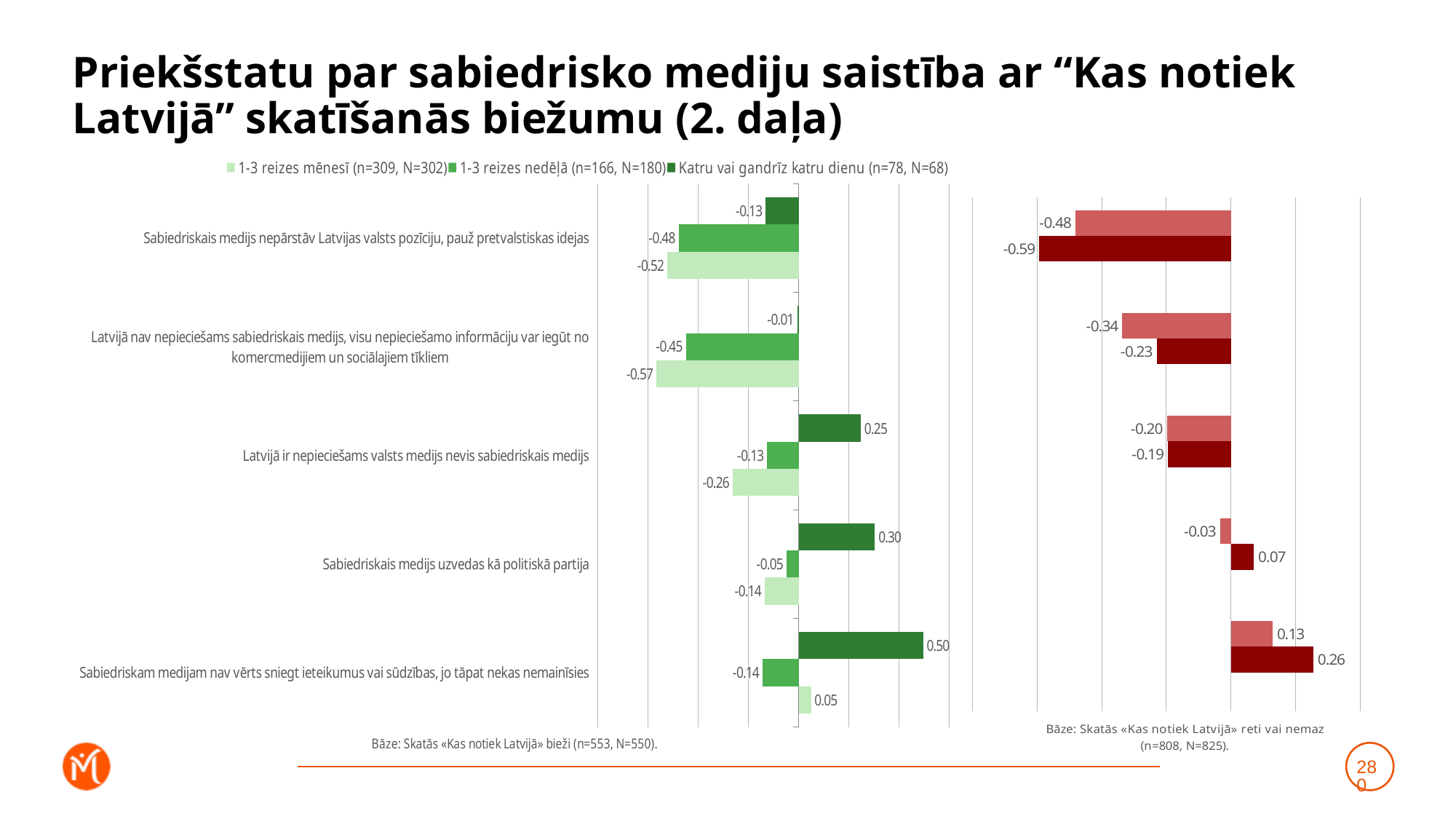
In the right chart, what is the value of the dark red bar for "Sabiedriskais medijs nepārstāv Latvijas valsts pozīciju, pauž pretvalstiskas idejas"? -0.59 In the left chart, what is the value for "Katru vai gandrīz katru dienu" for the statement "Sabiedriskam medijam nav vērts sniegt ieteikumus vai sūdzības, jo tāpat nekas nemainīsies"? 0.50 In the left chart, for "Latvijā ir nepieciešams valsts medijs nevis sabiedriskais medijs", which is larger: the value for "1-3 reizes nedēļā" or for "1-3 reizes mēnesī"? 1-3 reizes nedēļā How many statements (categories) are shown in the left chart? 5 In the left chart, what is the difference between the "Katru vai gandrīz katru dienu" value and the "1-3 reizes mēnesī" value for "Sabiedriskais medijs uzvedas kā politiskā partija"? 0.44 What kind of chart is the left chart? Bar chart How many series does the legend of the left chart list? 3 In the left chart, which statement has the highest value for "Katru vai gandrīz katru dienu"? Sabiedriskam medijam nav vērts sniegt ieteikumus vai sūdzības, jo tāpat nekas nemainīsies In the right chart, what is the value of the lighter red bar for "Sabiedriskam medijam nav vērts sniegt ieteikumus vai sūdzības, jo tāpat nekas nemainīsies"? 0.13 In the left chart, which statement has the lowest value for "1-3 reizes mēnesī"? Latvijā nav nepieciešams sabiedriskais medijs, visu nepieciešamo informāciju var iegūt no komercmedijiem un sociālajiem tīkliem In the left chart, what is the value for "1-3 reizes nedēļā" for the statement "Latvijā nav nepieciešams sabiedriskais medijs, visu nepieciešamo informāciju var iegūt no komercmedijiem un sociālajiem tīkliem"? -0.45 In the left chart, what is the value for "1-3 reizes mēnesī" for the statement "Sabiedriskais medijs nepārstāv Latvijas valsts pozīciju, pauž pretvalstiskas idejas"? -0.52